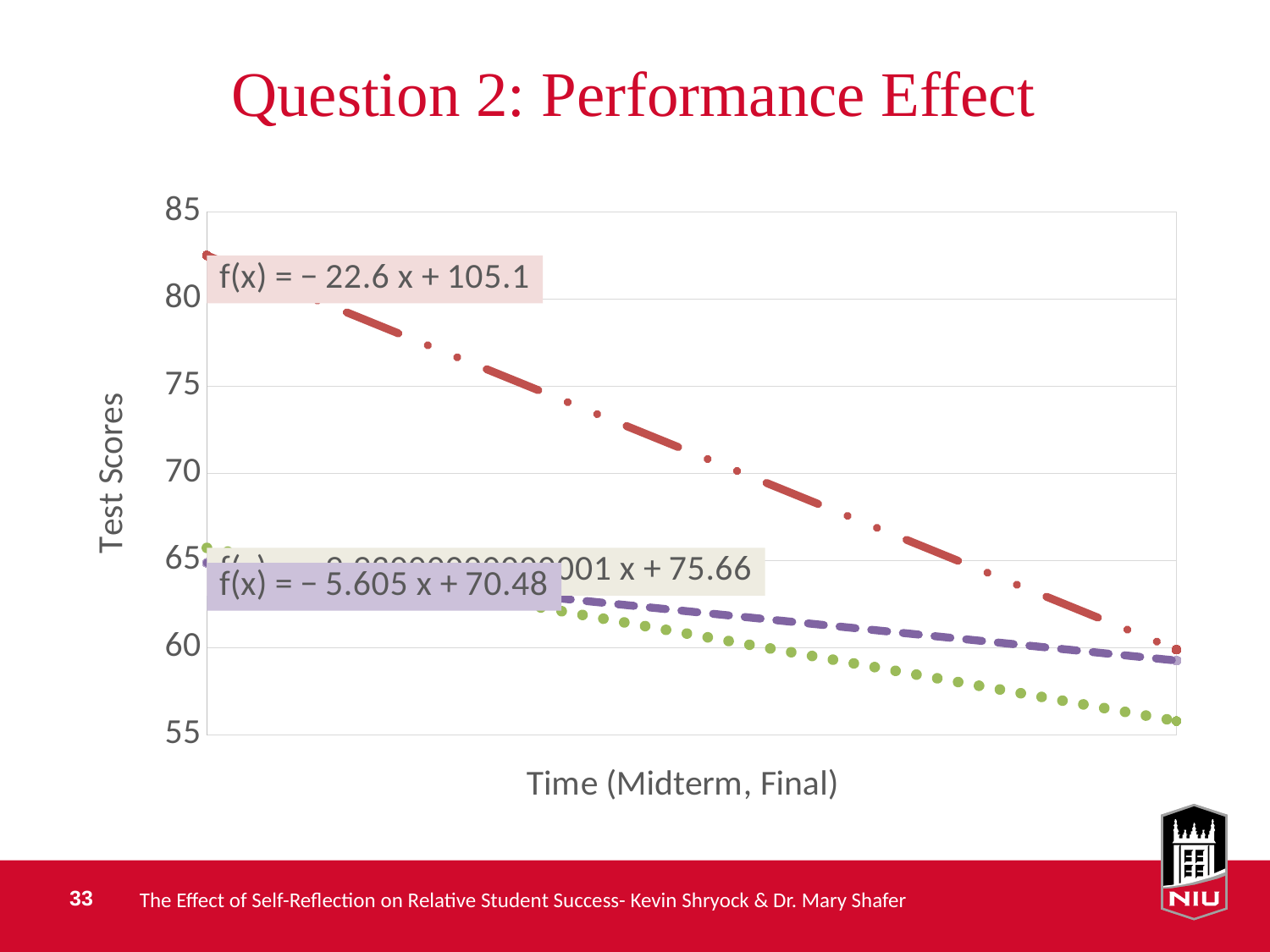
Is the value of the red line at the right end of the chart greater or less than 65? less Do the plotted lines rise or fall from left to right along the x axis? fall Is the value of the green dotted line at the right end of the chart greater or less than 60? less What is the title of the slide containing the chart? Question 2: Performance Effect How many lines are plotted on the chart? 3 At the left end of the chart, which line is higher: the red line or the purple dashed line? the red line At the right end of the chart, which line is higher: the red line or the green dotted line? the red line What kind of chart is shown on the slide? line chart Is the value of the purple dashed line at the left end of the chart greater or less than 70? less What is the label on the vertical axis of the chart? Test Scores